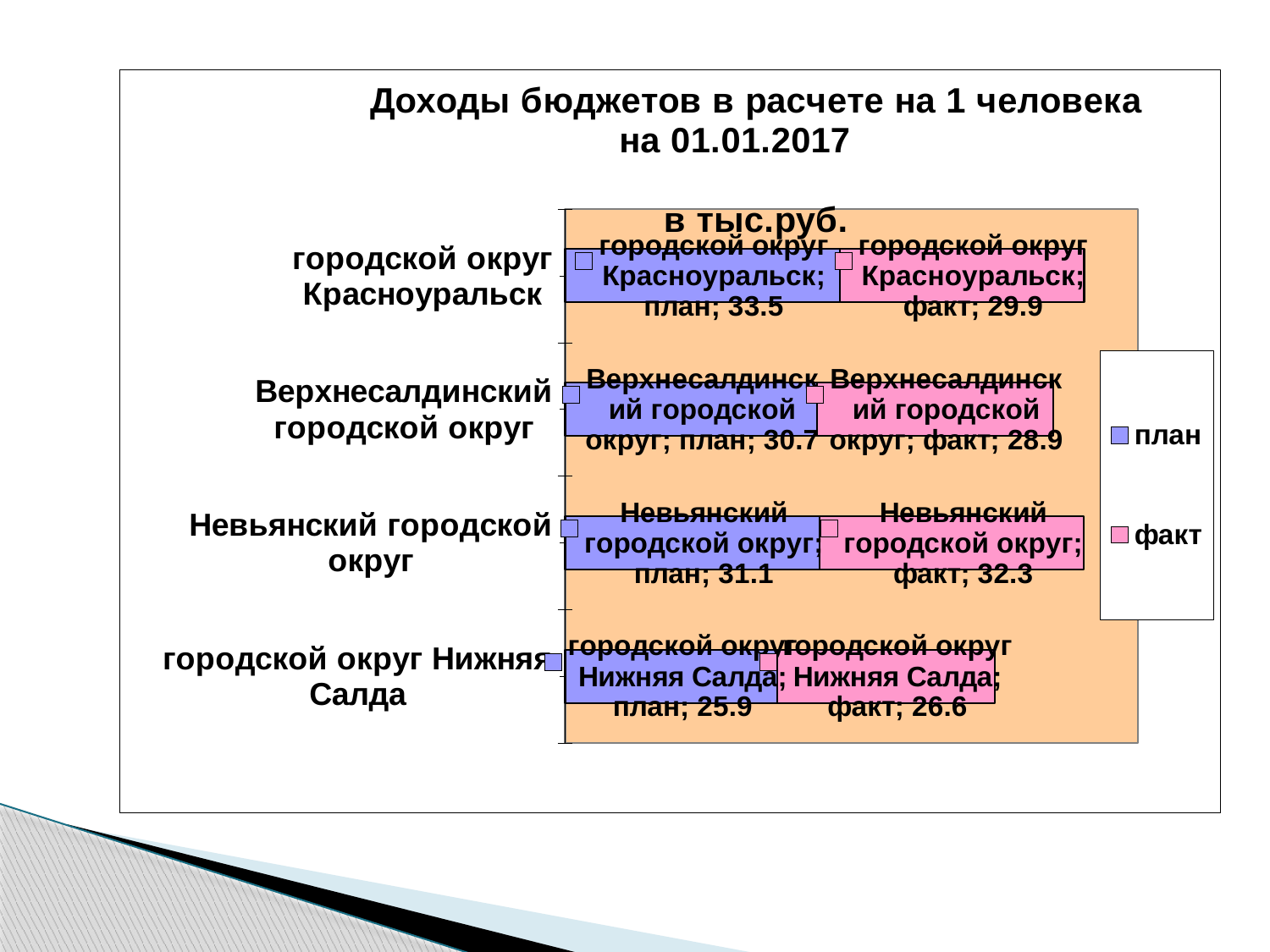
Which category has the lowest факт value? городской округ Нижняя Салда What is the план value for Верхнесалдинский городской округ? 30.7 Which is larger for Невьянский городской округ, план or факт? факт How many categories are shown in the chart? 4 How many series does the legend list? 2 What unit is stated in the chart title? тыс.руб. Which category has the highest план value? городской округ Красноуральск What is the факт value for городской округ Нижняя Салда? 26.6 What is the факт value for Невьянский городской округ? 32.3 What is the план value for городской округ Красноуральск? 33.5 What kind of chart is shown on the slide? bar chart What is the difference between the план and факт values for городской округ Красноуральск? 3.6